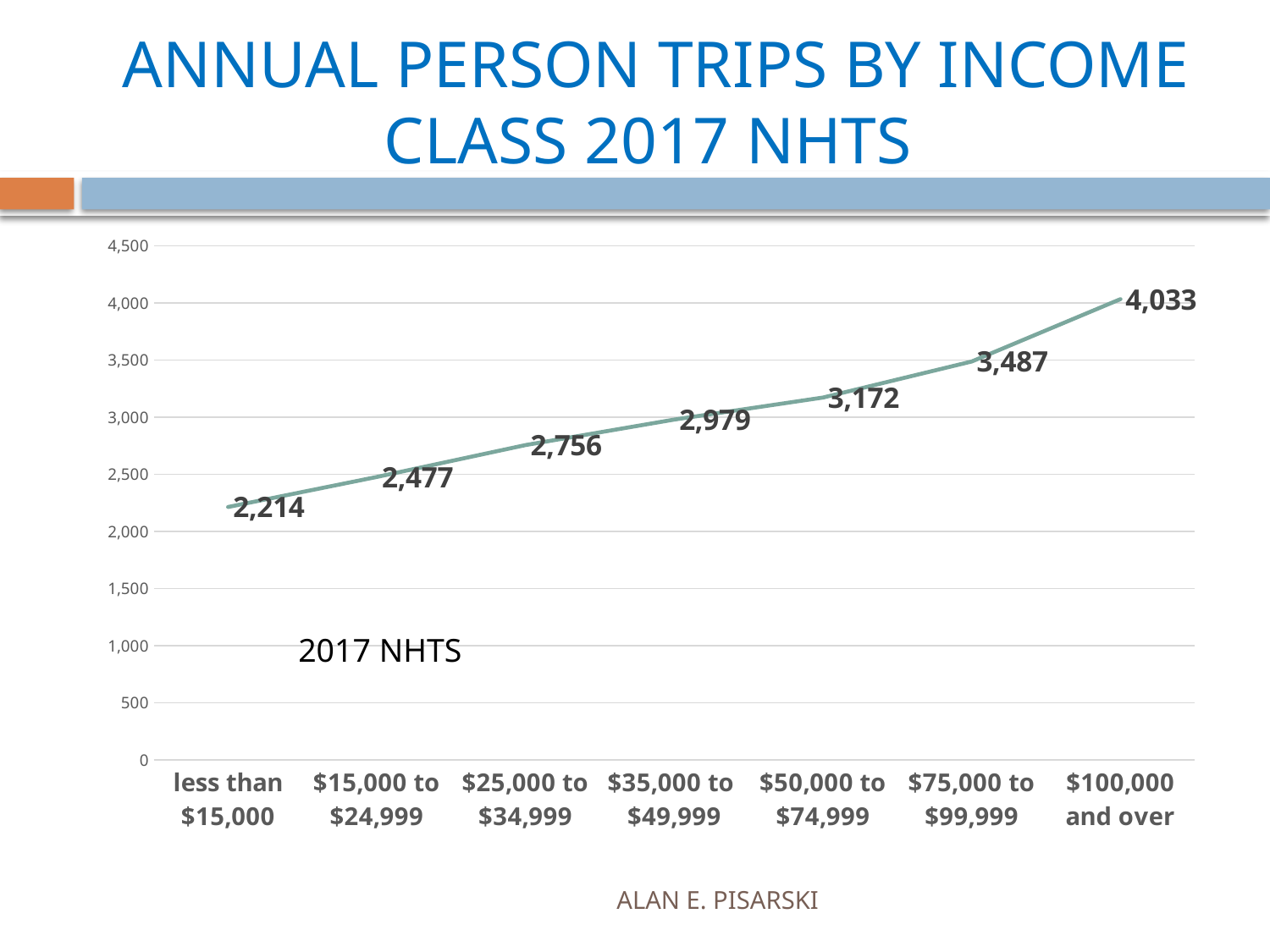
What kind of chart is shown on the slide? line chart Which is larger, the value for "$25,000 to $34,999" or the value for "$35,000 to $49,999"? $35,000 to $49,999 What is the title of the chart on the slide? ANNUAL PERSON TRIPS BY INCOME CLASS 2017 NHTS Do the values rise or fall as income class increases along the x axis? rise What is the difference between the values for "$100,000 and over" and "less than $15,000"? 1,819 What is the difference between the values for "$75,000 to $99,999" and "$50,000 to $74,999"? 315 Which income class has the highest number of annual person trips? $100,000 and over What is the value of annual person trips for the "less than $15,000" income class? 2,214 What is the value for the "$100,000 and over" income class? 4,033 How many income classes are plotted on the chart? 7 What is the value for the "$50,000 to $74,999" income class? 3,172 Which income class has the lowest number of annual person trips? less than $15,000